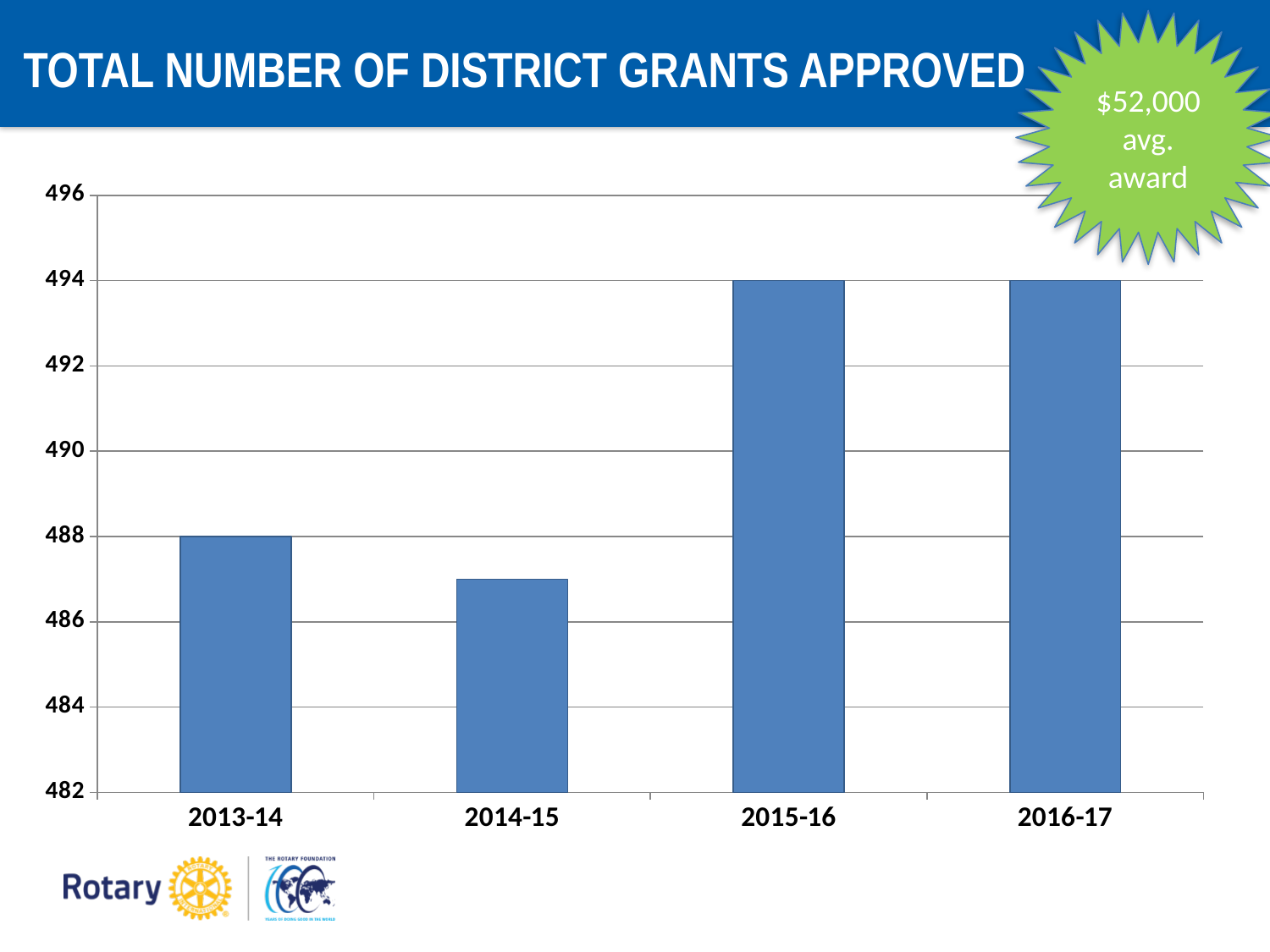
Which year has the lowest number of district grants approved? 2014-15 What kind of chart is shown on the slide? bar chart What is the value for 2013-14? 488 What is the difference between the values for 2015-16 and 2013-14? 6 What is the title of the chart? TOTAL NUMBER OF DISTRICT GRANTS APPROVED What is the value for 2016-17? 494 Which is larger, the value for 2013-14 or the value for 2015-16? 2015-16 Is the value for 2014-15 greater or less than 488? less Is the value for 2014-15 greater or less than 486? greater What is the value for 2015-16? 494 How many years are shown on the x axis? 4 What average award amount is shown in the starburst on the slide? $52,000